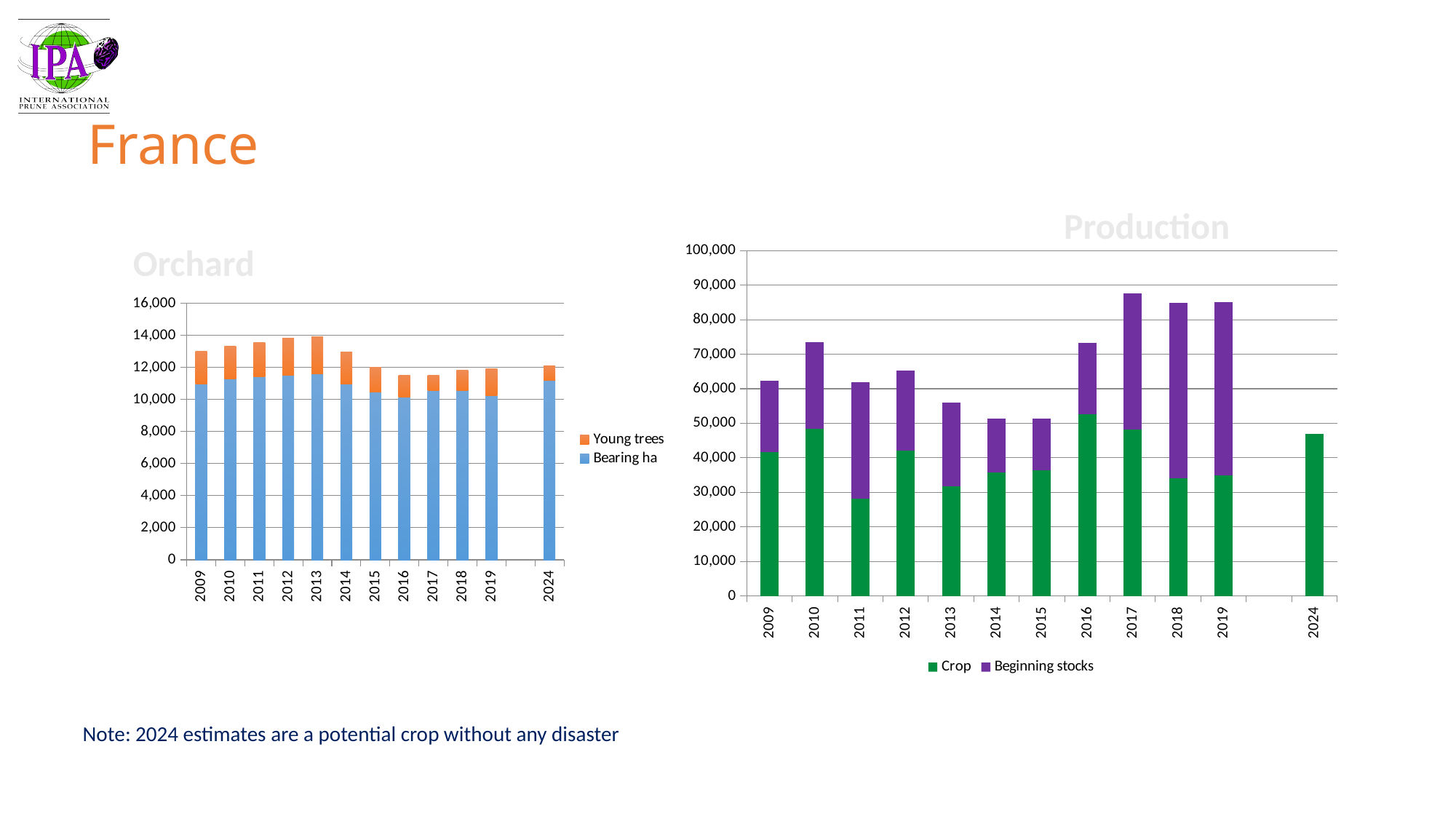
In the Orchard chart, is the total stacked value for 2009 greater or less than 12,000? greater How many series does the legend of the Production chart list? 2 How many years are shown on the x axis of the Orchard chart? 12 In the Production chart, does the total stacked value rise or fall from 2015 to 2017? rise In the Production chart, which year has the lowest Crop value? 2011 In the Production chart, which series is shown in purple? Beginning stocks In the Production chart, which year has the larger total stacked value, 2009 or 2010? 2010 In the Production chart, is the total stacked value for 2017 greater or less than 80,000? greater In the Production chart, is the Crop value for 2024 greater or less than 50,000? less In the Orchard chart, does the Bearing ha value rise or fall from 2013 to 2016? fall In the Production chart, which year has the highest Crop value? 2016 What kind of chart is the Orchard chart? bar chart